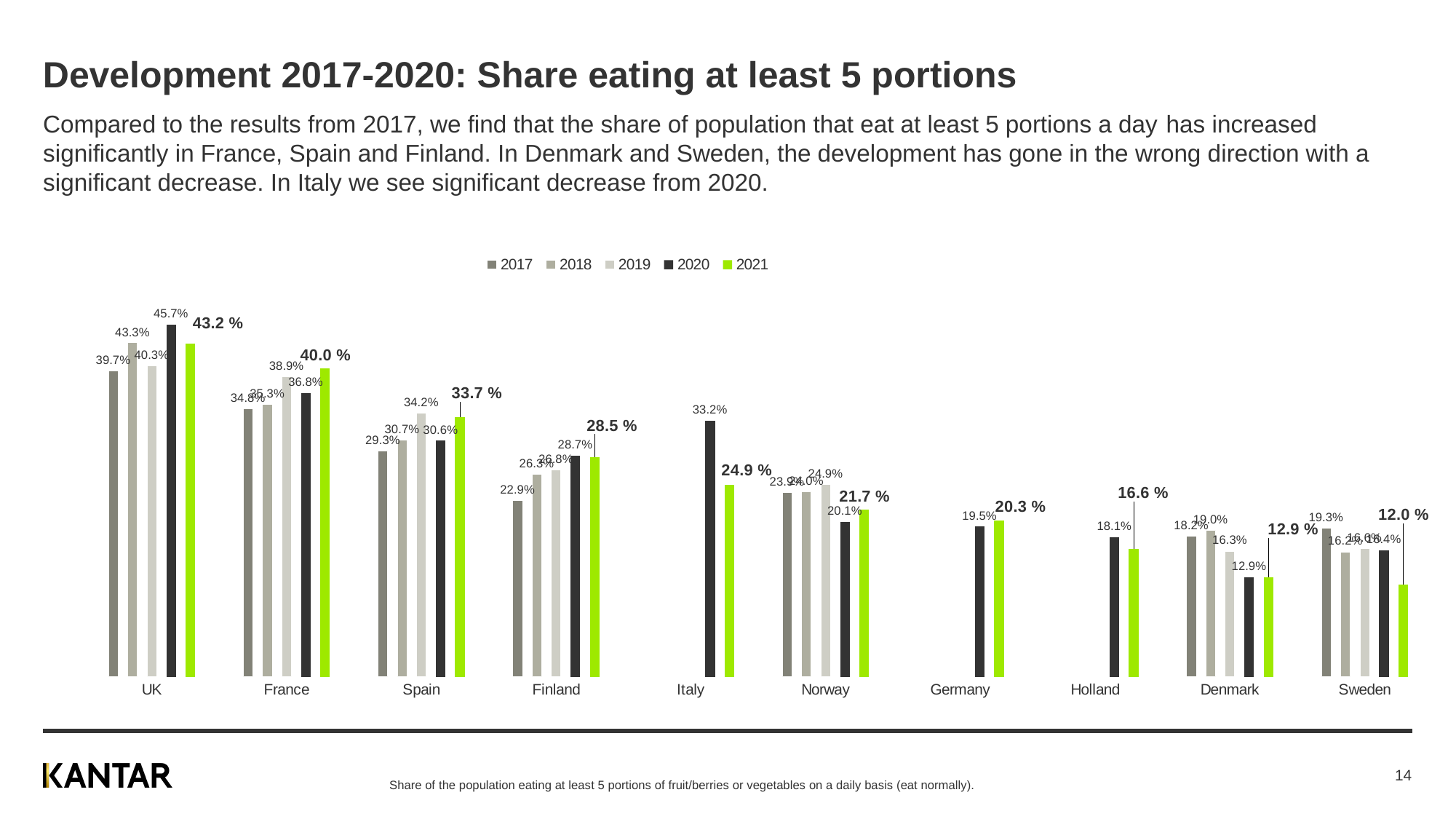
Which country has the lowest value in 2021? Sweden How many countries are shown on the x axis? 10 How many series does the legend list? 5 By how many percentage points did Italy's value fall from 2020 to 2021? 8.3 percentage points What is the value for Italy in 2021? 24.9 % Which is larger, the 2021 value for France or the 2021 value for Spain? France What is the value for Holland in 2021? 16.6 % What kind of chart is shown on the slide? Bar chart What is the value for Germany in 2020? 19.5% What is the value for the UK in 2020? 45.7% Did Finland's value rise or fall from 2017 to 2020? Rise Which country has the highest value in 2021? UK